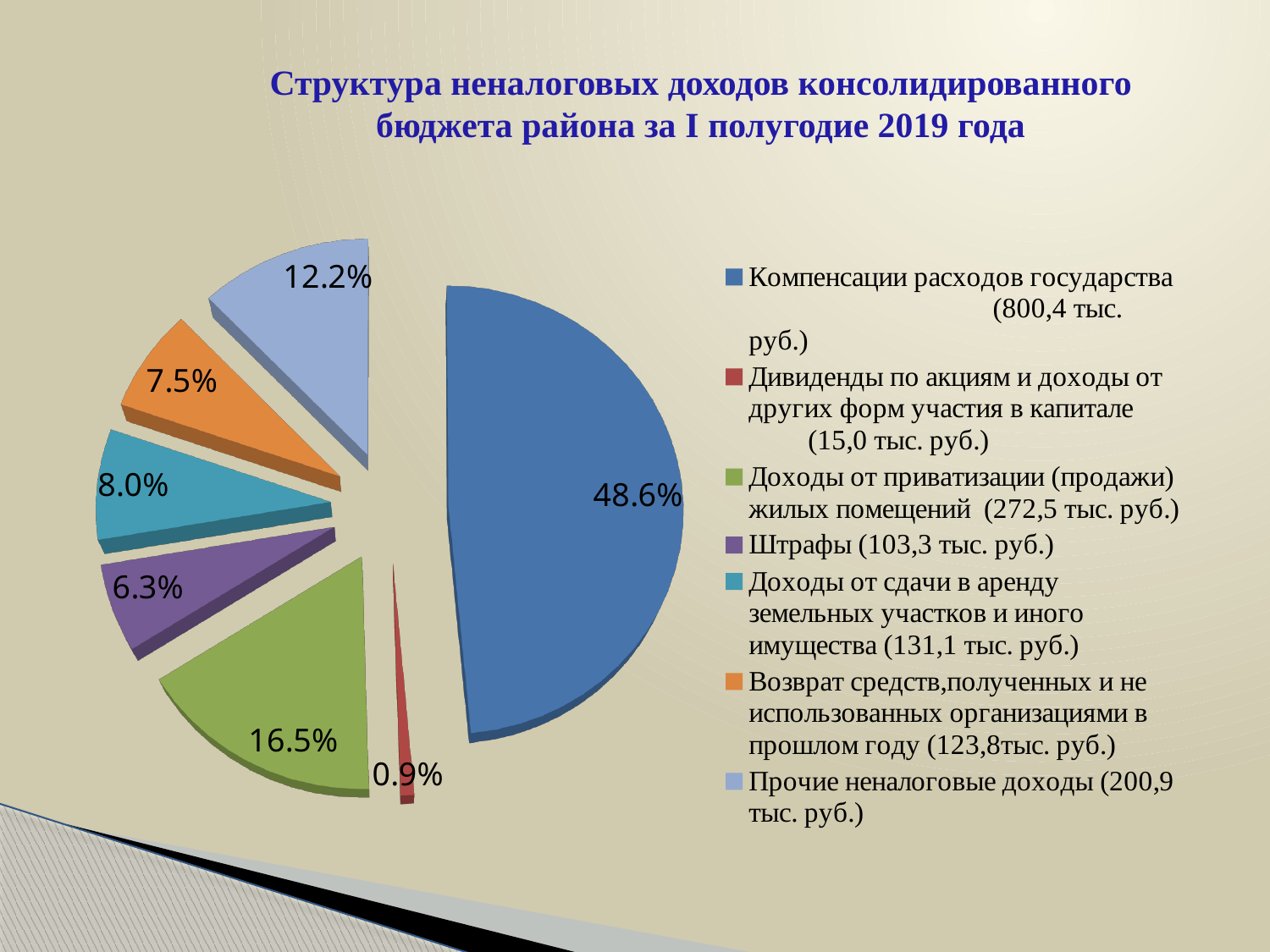
How many slices does the pie chart have? 7 What share of the pie is labelled for Прочие неналоговые доходы? 12.2% What kind of chart is shown on the slide? pie chart Which has the larger share: Прочие неналоговые доходы or Доходы от приватизации (продажи) жилых помещений? Доходы от приватизации (продажи) жилых помещений What colour is the slice for Дивиденды по акциям и доходы от других форм участия в капитале? red Which category has the smallest share of the pie? Дивиденды по акциям и доходы от других форм участия в капитале What share of the pie is labelled for Штрафы? 6.3% What is the difference in percentage points between the share for Доходы от сдачи в аренду земельных участков и иного имущества and the share for Возврат средств, полученных и не использованных организациями в прошлом году? 0.5 What share of the pie is labelled for Доходы от приватизации (продажи) жилых помещений? 16.5% Which category has the largest share of the pie? Компенсации расходов государства According to the legend, what amount in тыс. руб. is given for Штрафы? 103,3 тыс. руб.